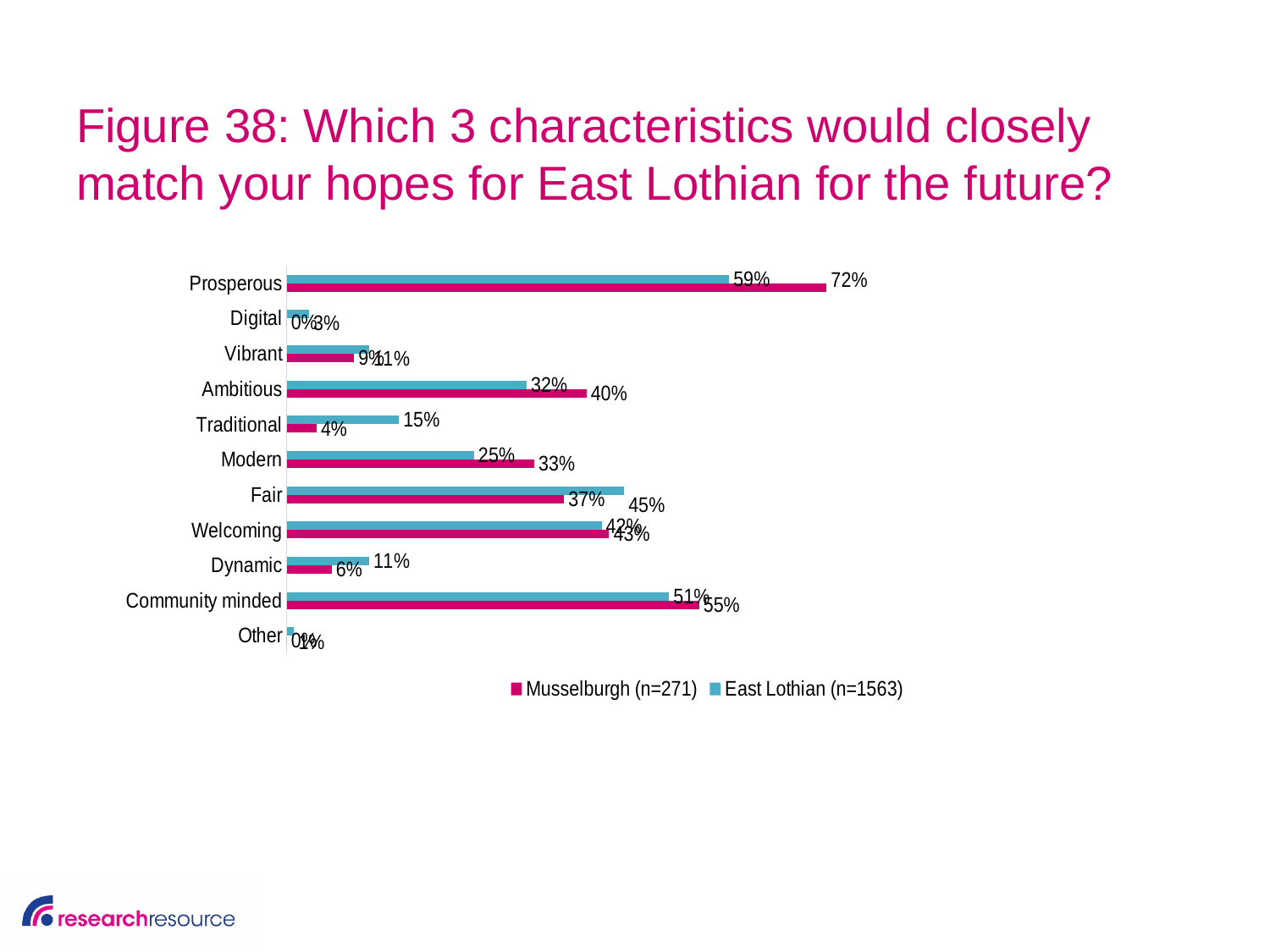
What percentage of East Lothian respondents chose Prosperous? 59% What kind of chart is shown on the slide? Bar chart What is the Musselburgh value for Ambitious? 40% Which characteristic has the highest Musselburgh value? Prosperous What is the Musselburgh value for Traditional? 4% What is the difference between the Musselburgh and East Lothian values for Prosperous? 13 percentage points For Traditional, which is larger: the Musselburgh value or the East Lothian value? East Lothian What is the East Lothian value for Traditional? 15% How many series does the legend list? 2 What is the East Lothian value for Fair? 45% How many characteristics are listed on the chart? 11 What percentage of Musselburgh respondents chose Prosperous? 72%